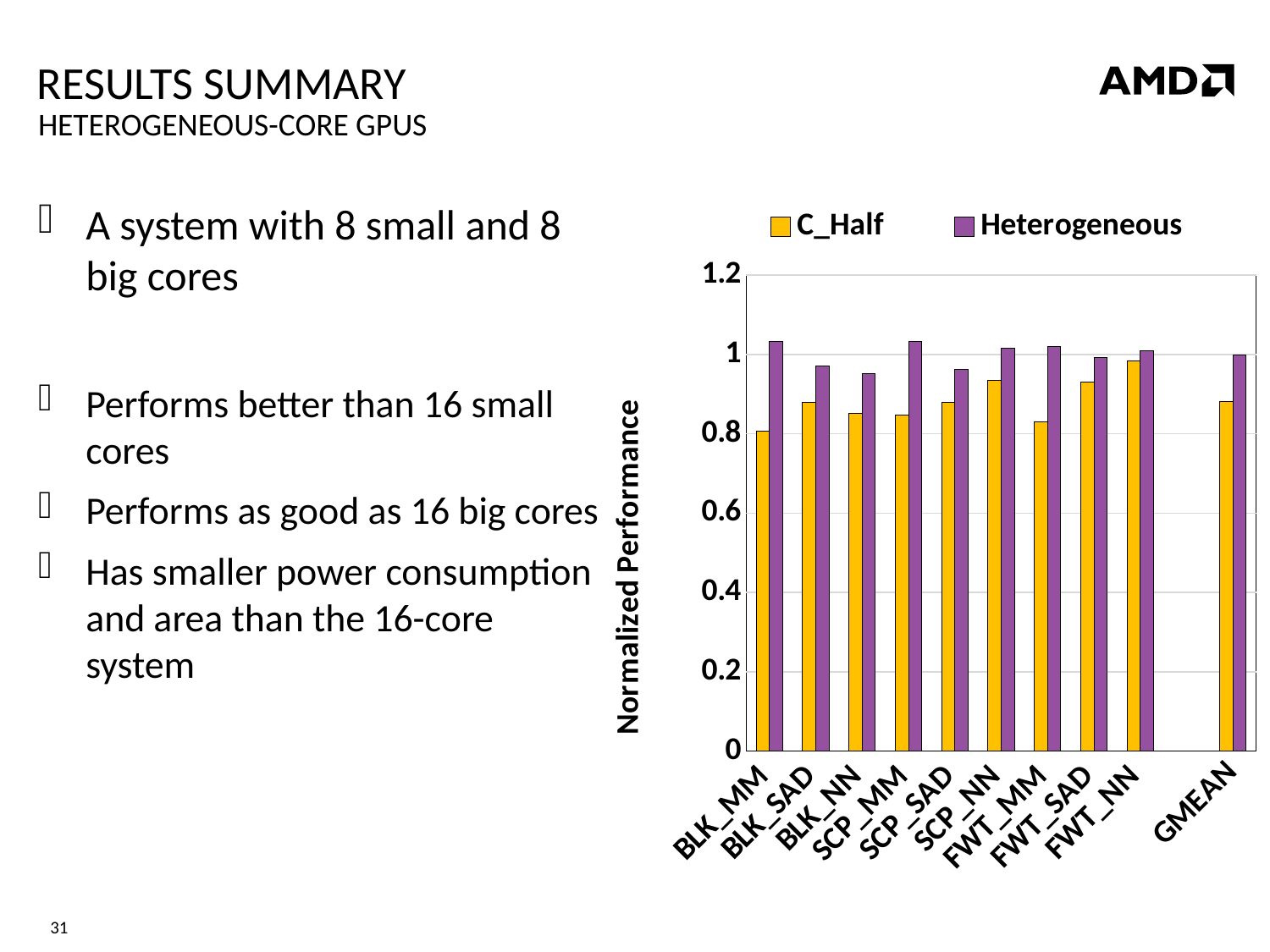
How many categories are shown on the x axis? 10 Which category has the highest C_Half value? FWT_NN Is the C_Half value for FWT_MM greater or less than 0.6? greater Is the C_Half value for SCP_NN greater or less than 0.8? greater Is the Heterogeneous value for GMEAN greater or less than 0.8? greater Which series is drawn in purple? Heterogeneous What is the label of the y axis? Normalized Performance How many series does the legend list? 2 What kind of chart is shown on the slide? bar chart For BLK_MM, which series has the larger value, C_Half or Heterogeneous? Heterogeneous For FWT_MM, which series has the larger value, C_Half or Heterogeneous? Heterogeneous